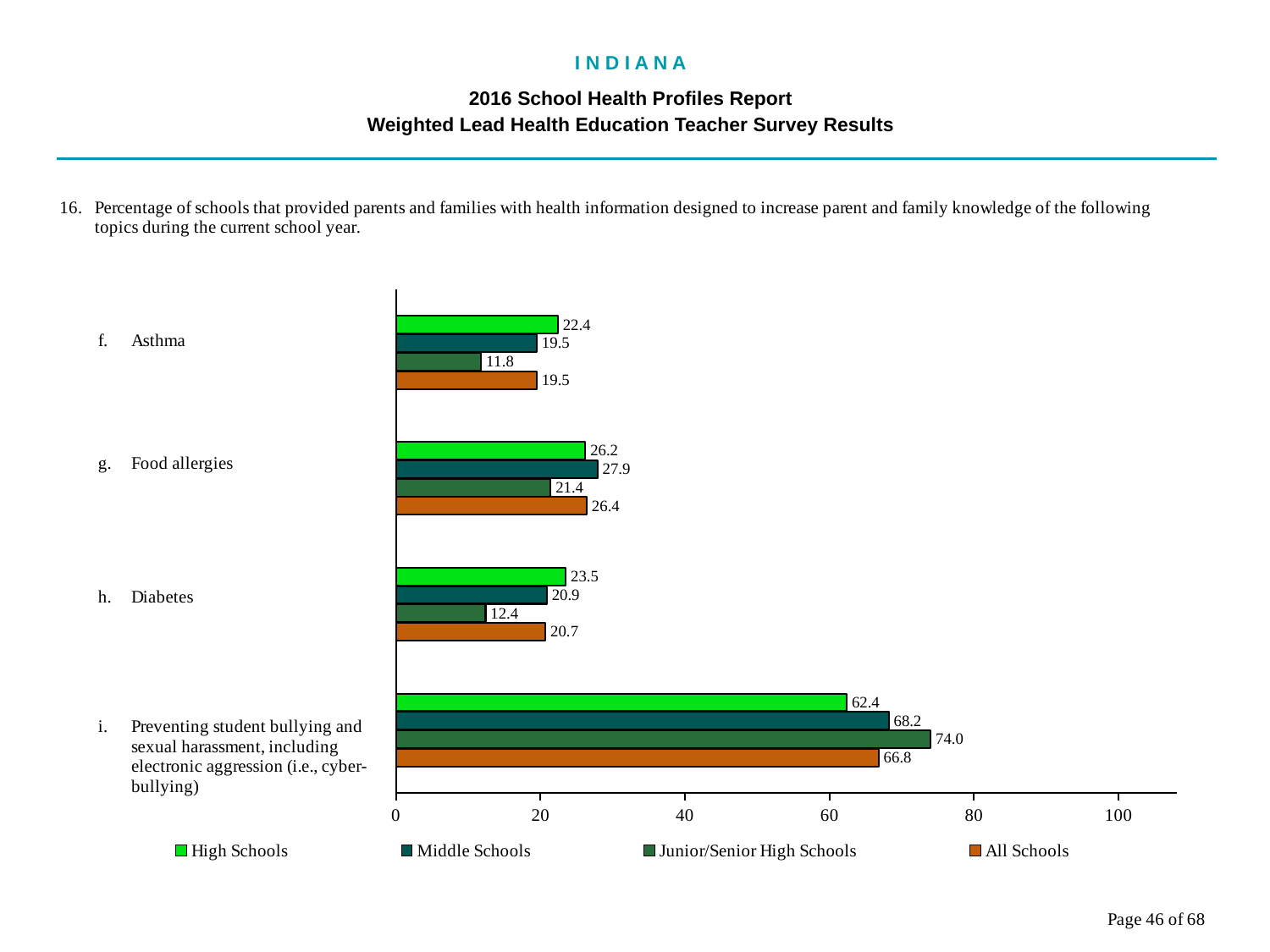
Which topic has the lowest value for Junior/Senior High Schools? Asthma What is the value for High Schools for Asthma? 22.4 How many topics are shown on the chart? 4 How many series does the legend list? 4 What is the difference between the Middle Schools and High Schools values for Preventing student bullying and sexual harassment? 5.8 What kind of chart is shown on the slide? bar chart What is the value for Middle Schools for Diabetes? 20.9 Which is larger for Food allergies: the Middle Schools value or the High Schools value? Middle Schools Which topic has the highest value for All Schools? Preventing student bullying and sexual harassment, including electronic aggression (i.e., cyber-bullying) What is the value for Junior/Senior High Schools for Preventing student bullying and sexual harassment? 74.0 Is the value for All Schools for Preventing student bullying and sexual harassment greater or less than 60? greater What is the value for All Schools for Food allergies? 26.4